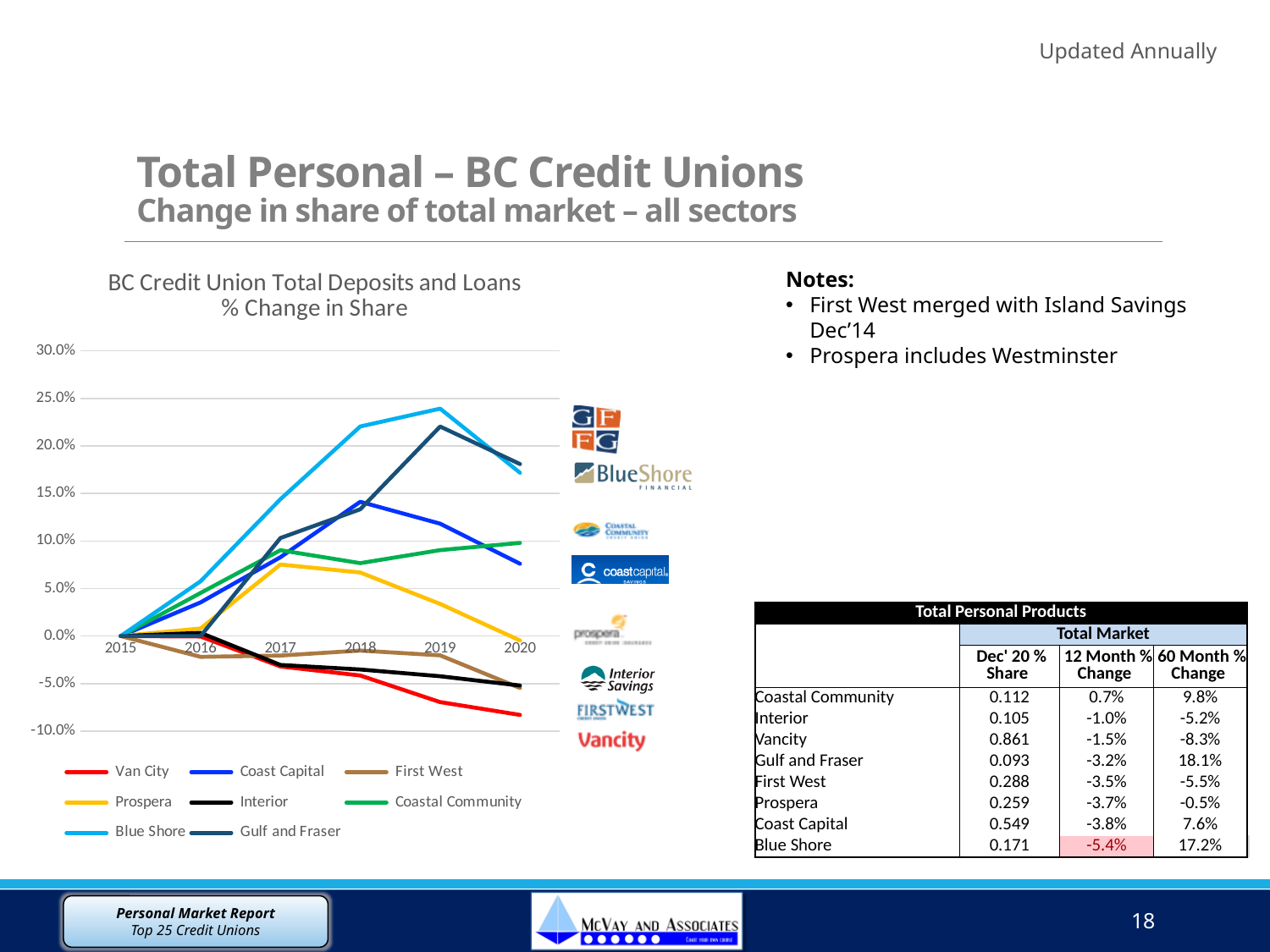
Is the value for Gulf and Fraser in 2019 greater or less than 20.0%? greater How many years are shown along the x axis of the chart? 6 Does the Van City line rise or fall from 2015 to 2020? fall How many series does the legend of the chart list? 8 What is the title of the chart? BC Credit Union Total Deposits and Loans % Change in Share Is the value for Blue Shore in 2019 greater or less than 20.0%? greater Which credit union has the lowest % change in share in 2020? Van City Which credit union has the highest % change in share in 2019? Blue Shore Is the value for Van City in 2020 greater or less than -5.0%? less What kind of chart is shown on the slide? line chart What colour is the Van City line in the chart? red In 2020, which is higher: Coastal Community or Coast Capital? Coastal Community